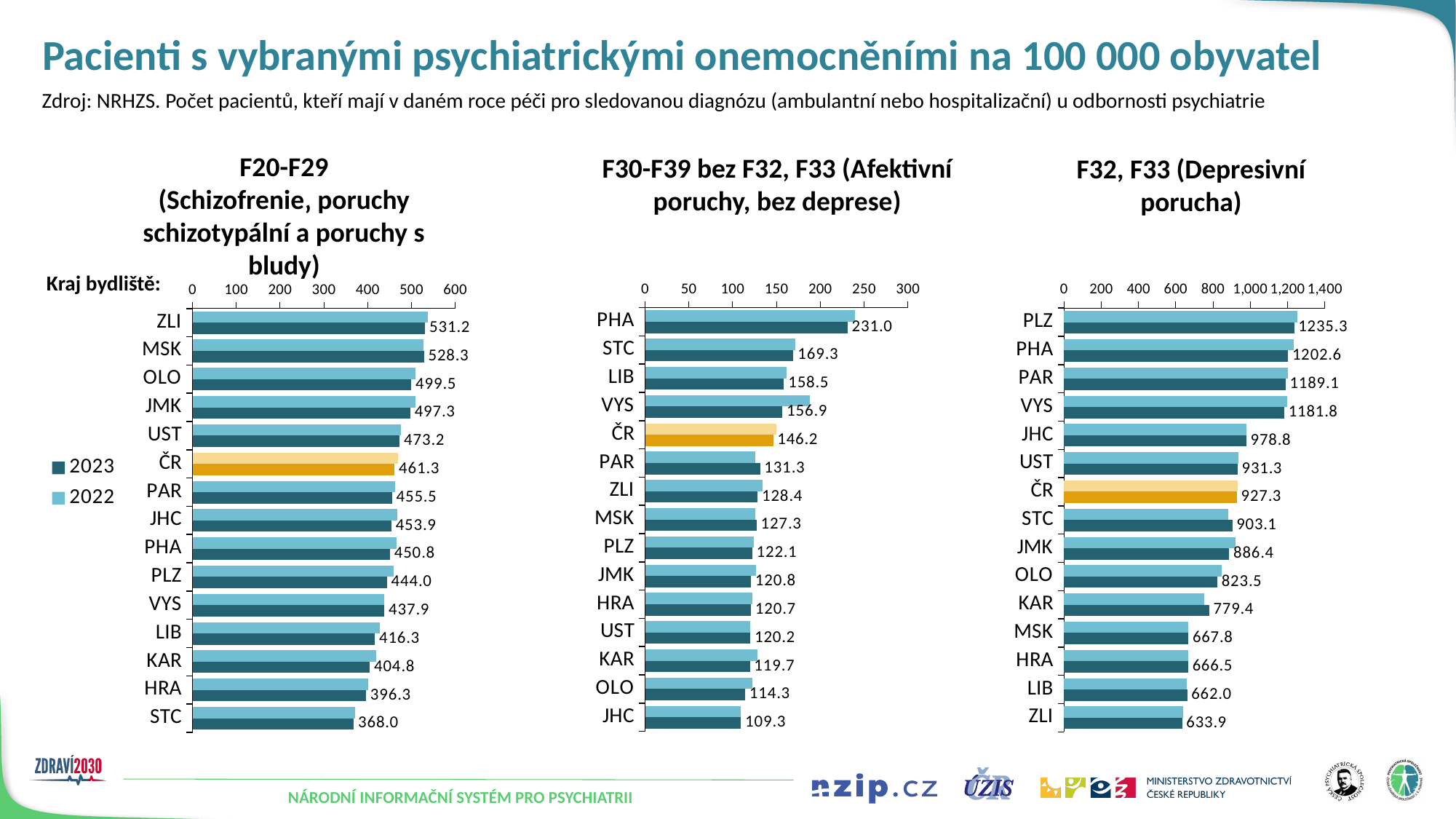
How many series does the legend list? 2 In the F32, F33 chart, is the 2023 value for KAR greater or less than 800? less In the F32, F33 chart, which has the larger 2023 value, JHC or STC? JHC In the F30-F39 bez F32, F33 chart, which region has the highest 2023 value? PHA In the F20-F29 chart, what is the 2023 value for ZLI? 531.2 In the F20-F29 chart, which region has the lowest 2023 value? STC In the F20-F29 chart, what is the difference between the 2023 values for ZLI and STC? 163.2 In the F32, F33 chart, which region has the lowest 2023 value? ZLI In the F30-F39 bez F32, F33 chart, what is the 2023 value for PHA? 231.0 How many regions (including ČR) are listed in the F20-F29 chart? 15 In the F32, F33 chart, what is the 2023 value for PLZ? 1235.3 In the F30-F39 bez F32, F33 chart, what is the 2023 value for ČR? 146.2